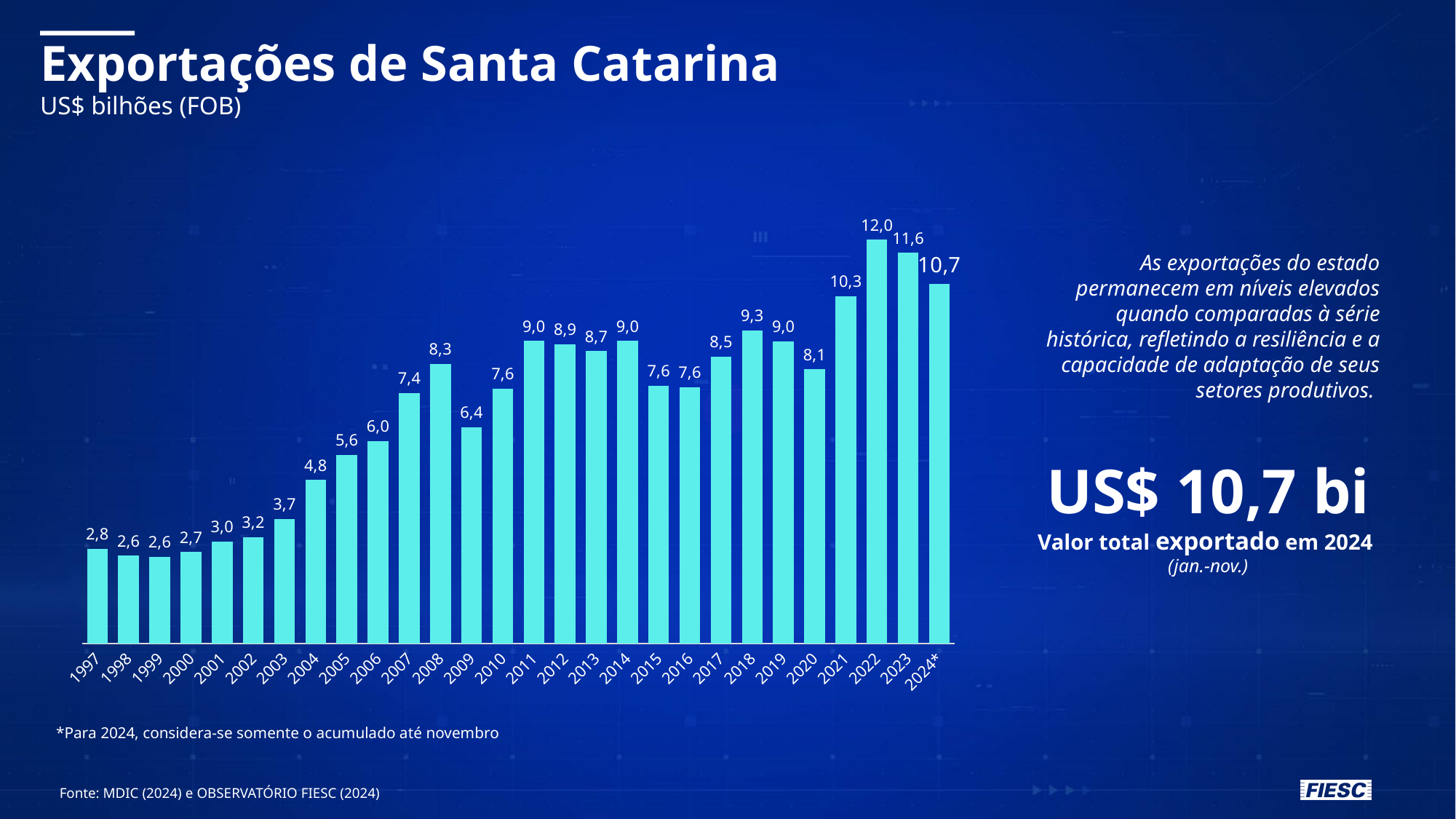
Do the export values generally rise or fall from 1997 to 2008? rise Which year has the highest export value? 2022 What is the export value for 2024*? 10,7 What is the difference between the export values for 2022 and 2021? 1,7 What is the export value for 2022? 12,0 What is the difference between the export values for 2008 and 2009? 1,9 How many years are shown on the x axis of the chart? 28 What is the export value for 2009? 6,4 What type of chart is shown on the slide? bar chart Which year has the larger export value, 2018 or 2020? 2018 What unit is stated in the chart's subtitle? US$ bilhões (FOB) What is the export value for 2004? 4,8